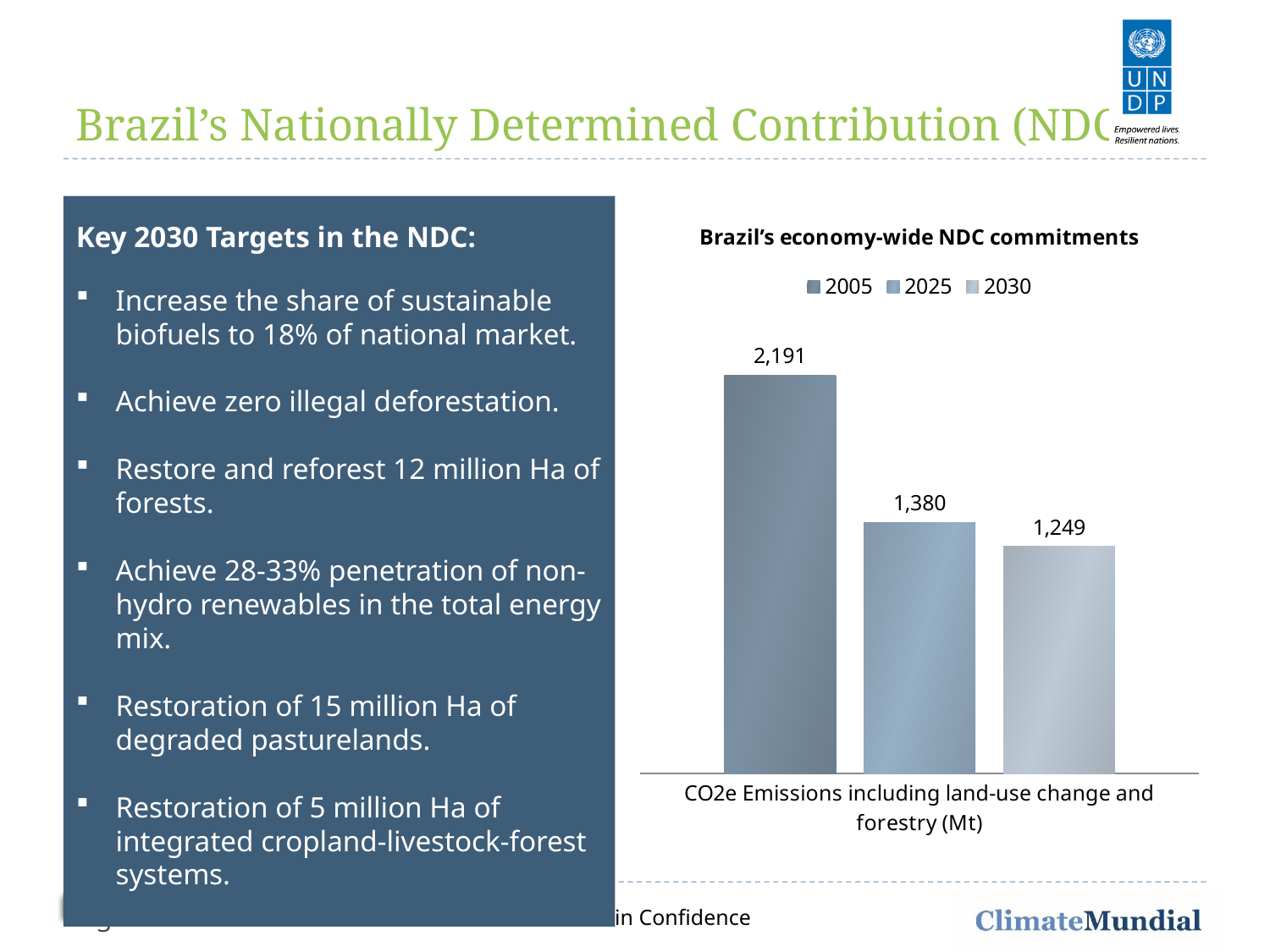
What is the difference between the 2025 and 2030 emissions values? 131 What is the title of the chart? Brazil's economy-wide NDC commitments Which year has the highest CO2e emissions value? 2005 Which year has the lowest CO2e emissions value? 2030 How many series does the legend list? 3 Do the emissions values rise or fall from 2005 to 2030? Fall Which is larger, the value for 2025 or the value for 2030? 2025 What is the CO2e emissions value for 2025? 1,380 What is the CO2e emissions value for 2030? 1,249 What is the difference between the 2005 and 2030 emissions values? 942 What is the CO2e emissions value for 2005? 2,191 What kind of chart is shown on the slide? Bar chart